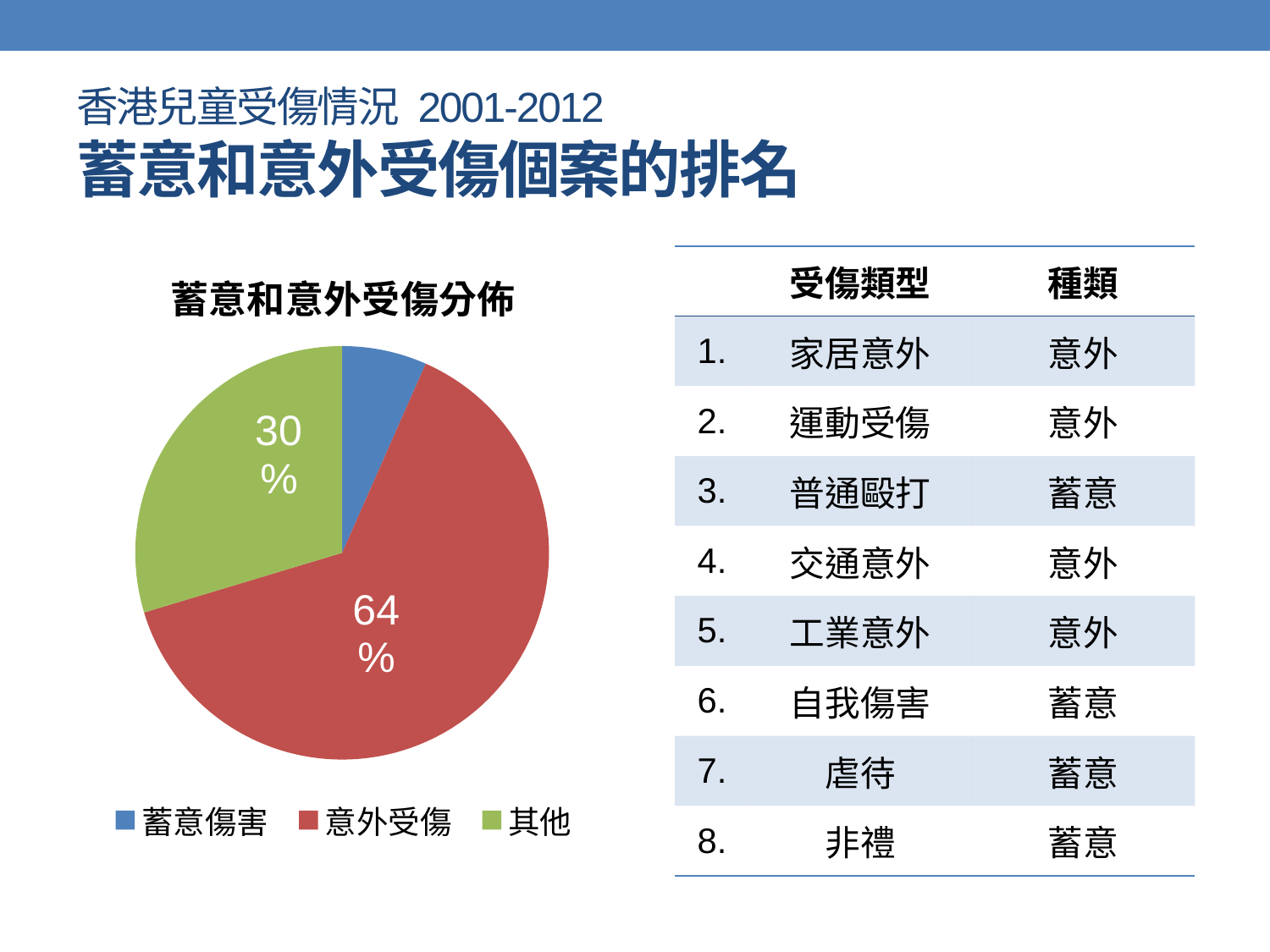
How many entries does the legend list? 3 How many slices does the pie chart have? 3 What is the difference in percentage points between the 意外受傷 slice and the 其他 slice? 34% What colour is the 蓄意傷害 slice in the pie chart? blue What kind of chart is shown on the slide? pie chart What is the title of the pie chart? 蓄意和意外受傷分佈 Which category has the smallest slice of the pie? 蓄意傷害 Which is larger, the slice for 其他 or the slice for 蓄意傷害? 其他 What share of the pie does 意外受傷 take? 64% What share of the pie does 其他 take? 30% Which category has the largest slice of the pie? 意外受傷 Which is larger, the slice for 意外受傷 or the slice for 其他? 意外受傷